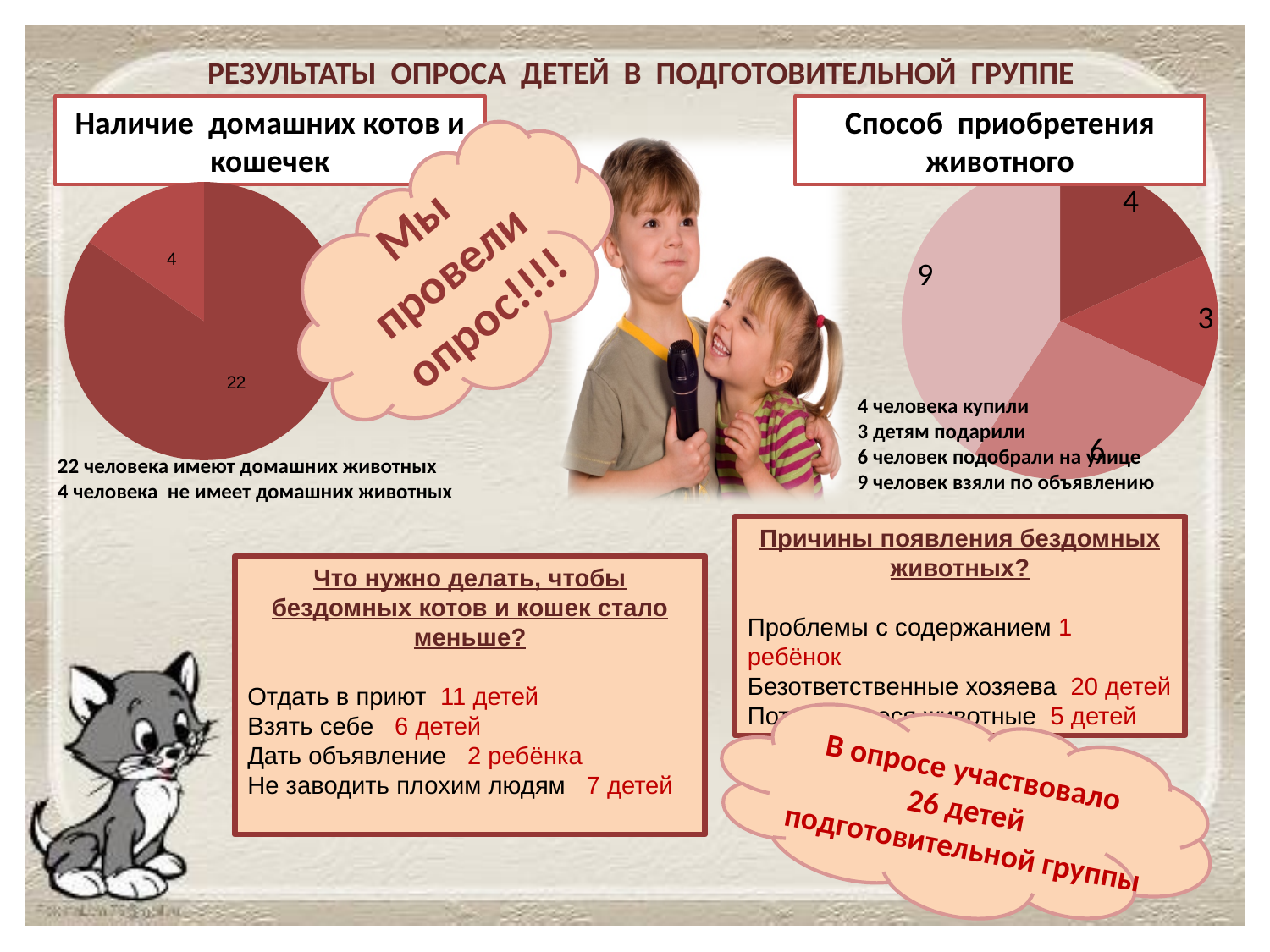
In the chart "Наличие домашних котов и кошечек", what is the value of the largest slice? 22 In the chart "Наличие домашних котов и кошечек", what is the value of the smallest slice? 4 In the chart "Способ приобретения животного", what is the value of the largest slice? 9 In the chart "Способ приобретения животного", what is the total of all slice values? 22 In the chart "Способ приобретения животного", how many slices does the pie have? 4 In the chart "Наличие домашних котов и кошечек", what is the difference between the two slice values? 18 In the chart "Наличие домашних котов и кошечек", how many slices does the pie have? 2 In the chart "Способ приобретения животного", what is the value of the smallest slice? 3 What kind of chart is the chart titled "Наличие домашних котов и кошечек"? pie chart What kind of chart is the chart titled "Способ приобретения животного"? pie chart In the chart "Наличие домашних котов и кошечек", what is the total of all slice values? 26 In the chart "Способ приобретения животного", what is the difference between the largest and smallest slice values? 6